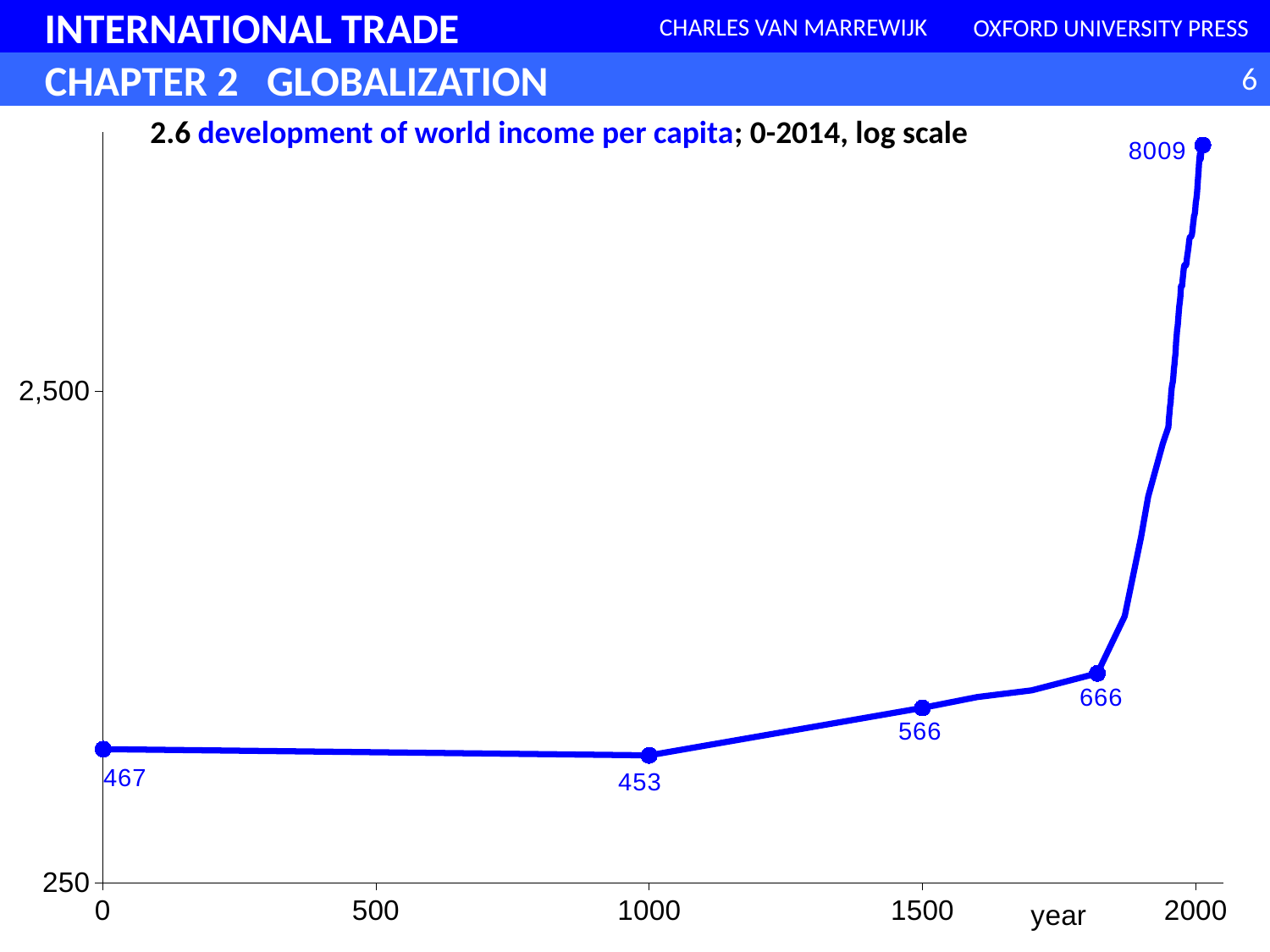
Which is larger, the value at year 0 or the value at year 1000? year 0 What is the difference between the highest labelled value (8009) and the labelled value 666? 7343 What is the difference between the values labelled at year 1500 and year 1000? 113 What is the value labelled at the last data point on the right of the line? 8009 What is the value labelled at year 1000? 453 What is the value labelled at year 1500? 566 How many data points are labelled with values on the chart? 5 What kind of chart is shown on the slide? line chart What is the world income per capita value labelled at year 0? 467 What is the highest labelled value on the chart? 8009 Which labelled point has the lowest value? 453 (year 1000) Is the value at year 1500 greater or less than 2,500? less